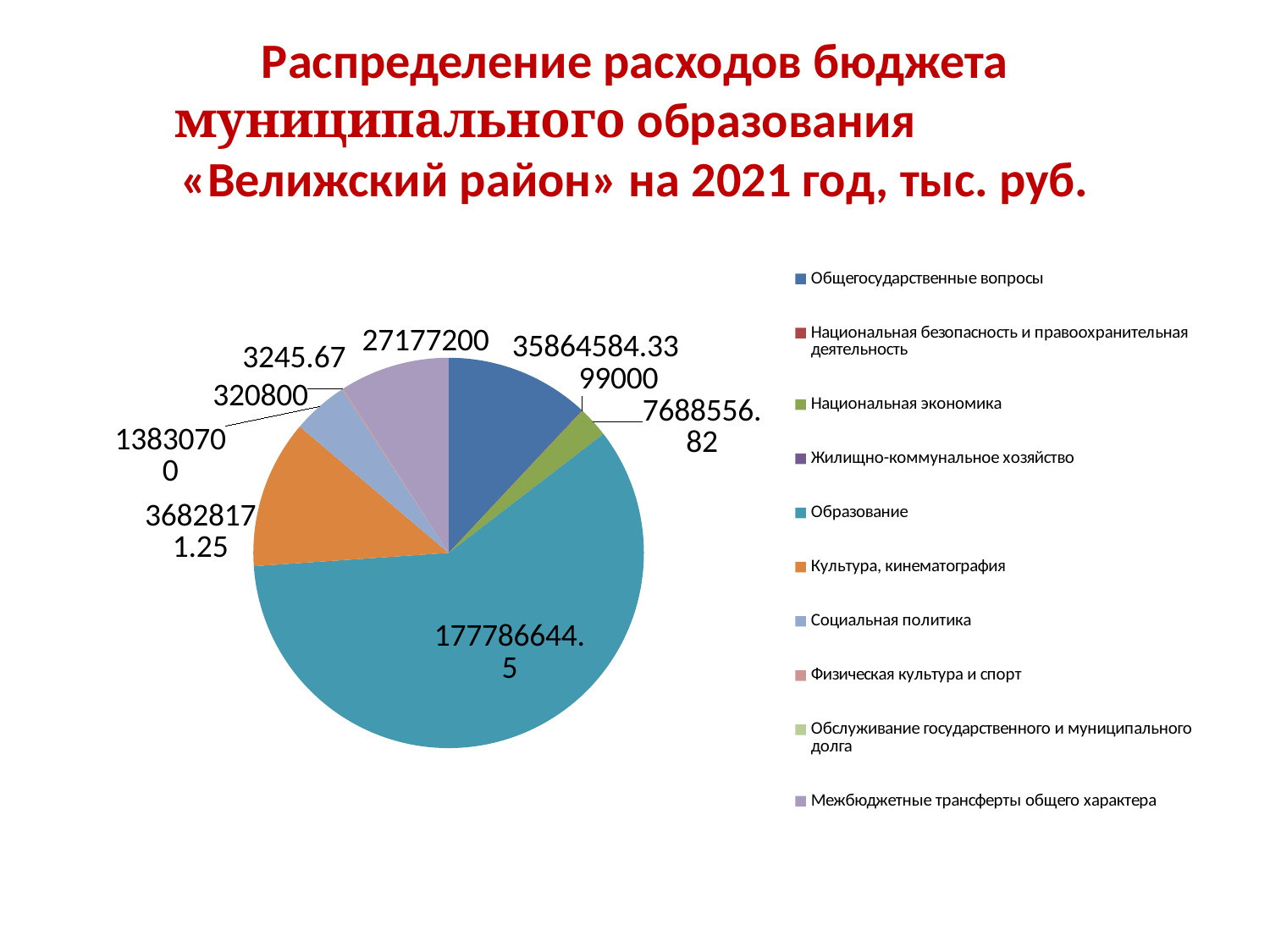
What is the value shown for Социальная политика? 13830700 Which category has the largest slice of the pie? Образование What is the difference between the values for Межбюджетные трансферты общего характера and Социальная политика? 13346500 Which is larger: the value for Культура, кинематография or the value for Общегосударственные вопросы? Культура, кинематография How many entries does the legend of the pie chart list? 10 What is the value shown for Межбюджетные трансферты общего характера? 27177200 What is the value shown for Культура, кинематография? 36828171.25 What kind of chart is shown on the slide? pie chart What is the value shown for Общегосударственные вопросы? 35864584.33 What is the difference between the values for Образование and Культура, кинематография? 140958473.25 What is the value shown for Национальная экономика? 7688556.82 What is the value shown for Образование? 177786644.5